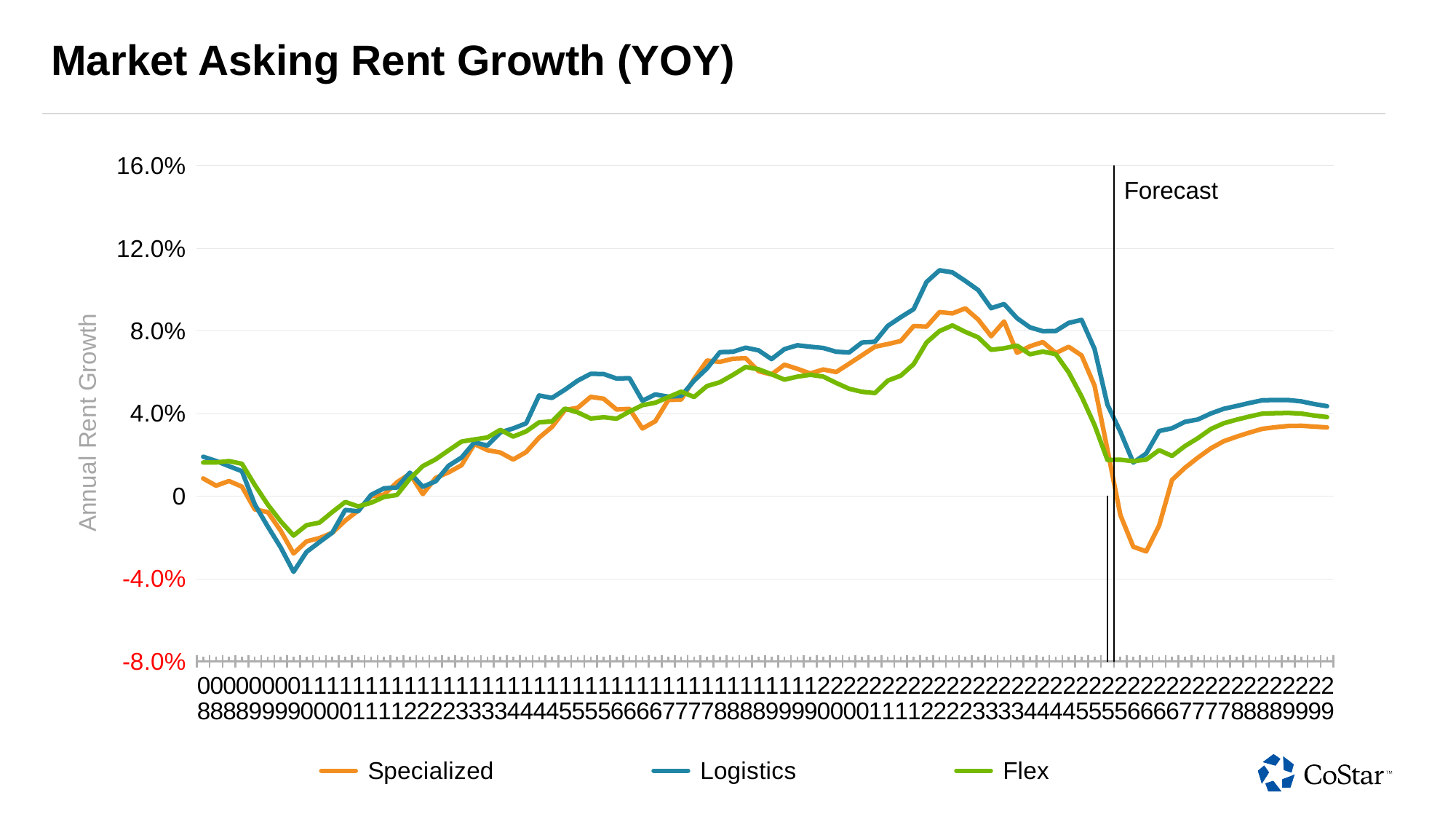
Do the values generally rise or fall from 2010 to 2022? Rise Which series reaches the lowest value on the chart? Logistics What kind of chart is shown on the slide? Line chart Is the peak value for Logistics greater or less than 8.0%? greater At the peak around 2022, which series is higher, Logistics or Flex? Logistics What is the label on the vertical axis? Annual Rent Growth Is the peak value for Logistics greater or less than 12.0%? less Is the lowest value for Specialized in the forecast period greater or less than 0? less Which series reaches the highest peak on the chart? Logistics How many series does the legend list? 3 What is the title of the chart? Market Asking Rent Growth (YOY)